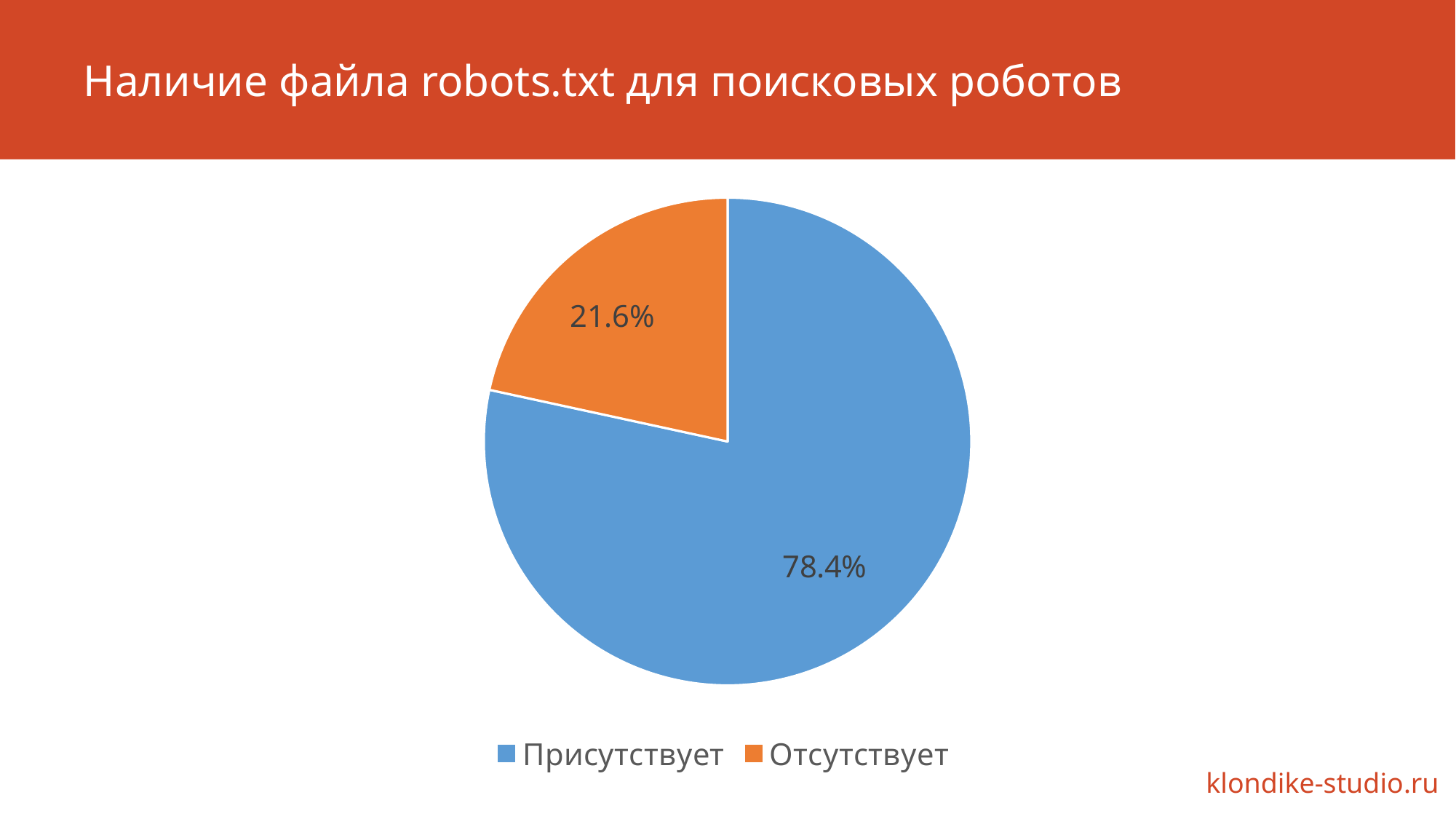
How many slices does the pie chart have? 2 What share of the pie does "Присутствует" take? 78.4% What colour is the "Отсутствует" slice? orange What kind of chart is shown on the slide? pie chart What is the title of the slide above the chart? Наличие файла robots.txt для поисковых роботов Which is larger, the "Присутствует" slice or the "Отсутствует" slice? Присутствует Which slice is the largest? Присутствует What is the difference in percentage points between the "Присутствует" and "Отсутствует" slices? 56.8 How many entries does the legend list? 2 What share of the pie does "Отсутствует" take? 21.6% Which slice is the smallest? Отсутствует